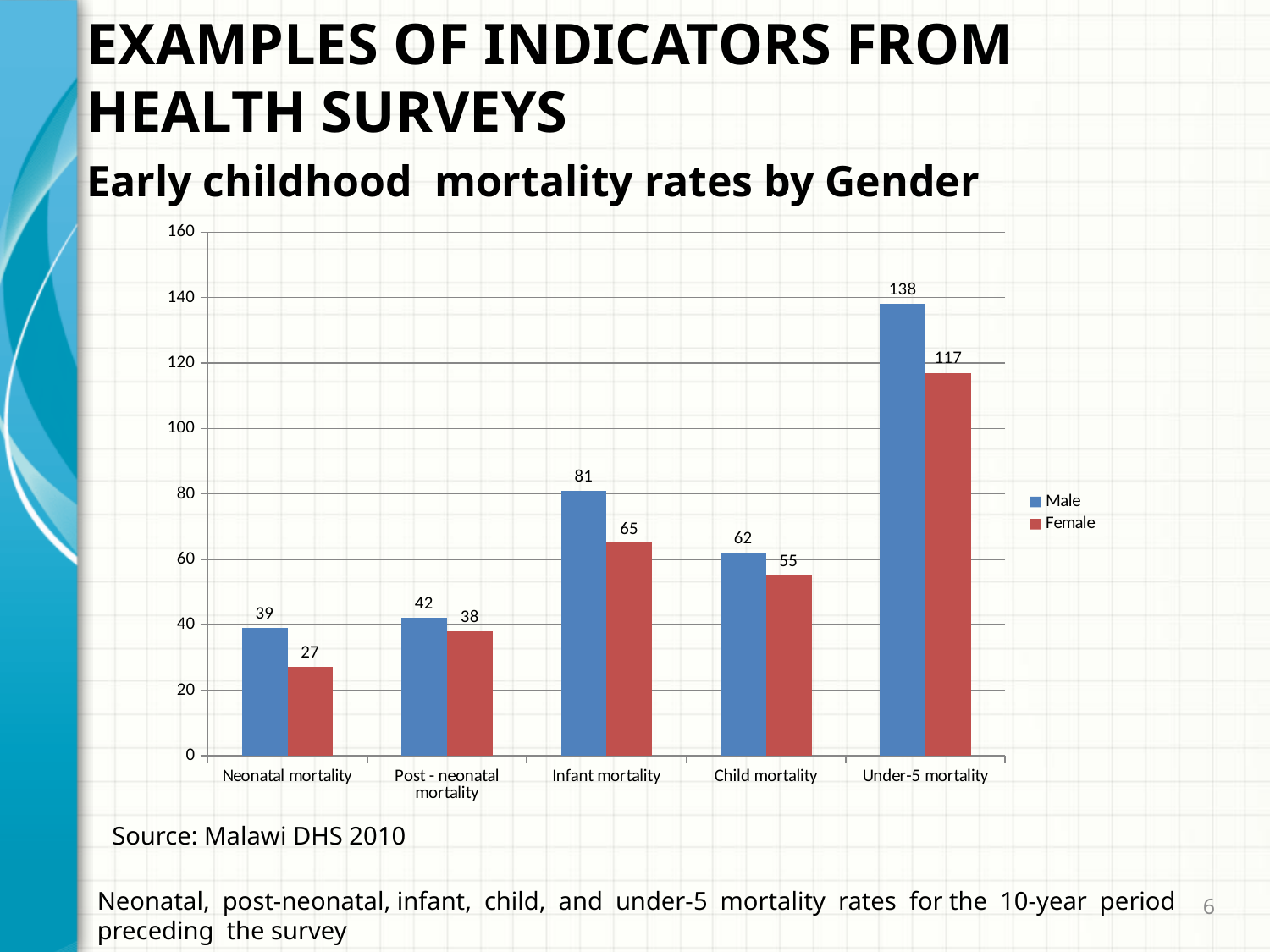
Which is larger, the Male value for Post - neonatal mortality or the Female value for Post - neonatal mortality? Male Which category has the lowest Female value? Neonatal mortality Is the Male value for Infant mortality greater or less than 100? less What kind of chart is shown on the slide? bar chart How many series does the legend list? 2 What is the Female value for Under-5 mortality? 117 What is the Female value for Neonatal mortality? 27 What is the difference between the Male and Female values for Child mortality? 7 How many categories are shown on the x axis? 5 Which category has the highest Male value? Under-5 mortality What is the difference between the Male and Female values for Under-5 mortality? 21 What is the Male value for Infant mortality? 81